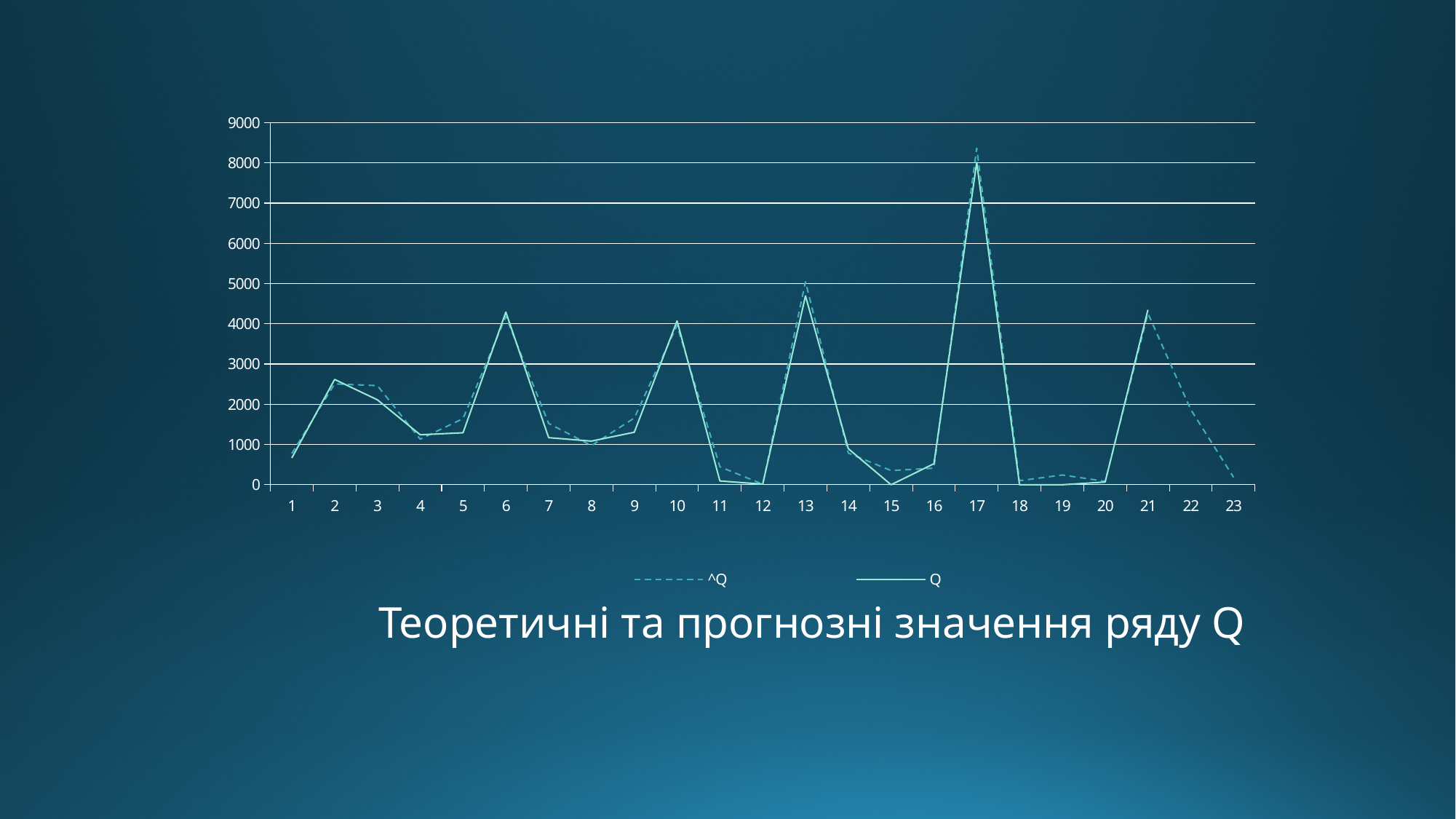
What kind of chart is shown on the slide? line chart Which is larger for the Q series: the value at point 17 or the value at point 6? point 17 How many series does the legend list? 2 Is the value of Q at point 12 greater or less than 1000? less What is the title shown below the chart? Теоретичні та прогнозні значення ряду Q At which x-axis point does the Q series reach its highest value? 17 Is the value of Q at point 6 greater or less than 3000? greater Which is larger for the Q series: the value at point 2 or the value at point 4? point 2 What are the two series named in the legend? ^Q and Q Is the value of Q at point 17 greater or less than 7000? greater How many points are labelled on the x axis? 23